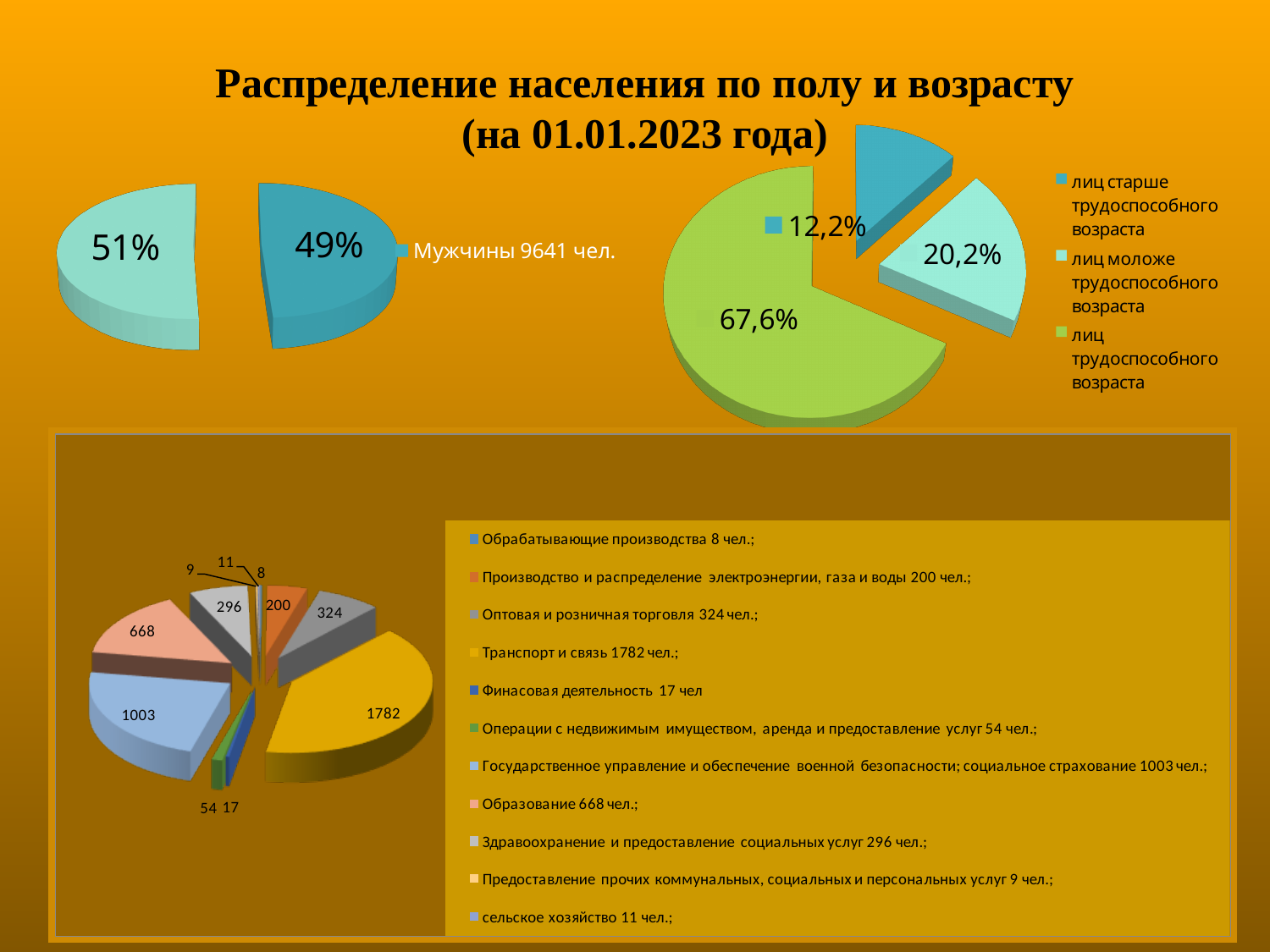
On the top-right pie chart, how many entries does the legend list? 3 On the bottom pie chart, how many categories are shown? 11 On the bottom pie chart, what is the value for Образование? 668 What kind of chart is the bottom chart on the slide? pie chart On the top-left pie chart, what is the larger of the two percentages shown? 51% On the bottom pie chart, which category has the largest value? Транспорт и связь On the top-left pie chart, how many slices does the pie have? 2 On the top-left pie chart, what share is shown for Мужчины? 49% On the top-right pie chart, what share is shown for лиц трудоспособного возраста? 67,6% On the bottom pie chart, what is the difference between the values for Транспорт и связь and Государственное управление и обеспечение военной безопасности; социальное страхование? 779 On the top-right pie chart, what is the difference between the shares for лиц трудоспособного возраста and лиц моложе трудоспособного возраста? 47,4% On the top-right pie chart, which category has the smallest share? лиц старше трудоспособного возраста